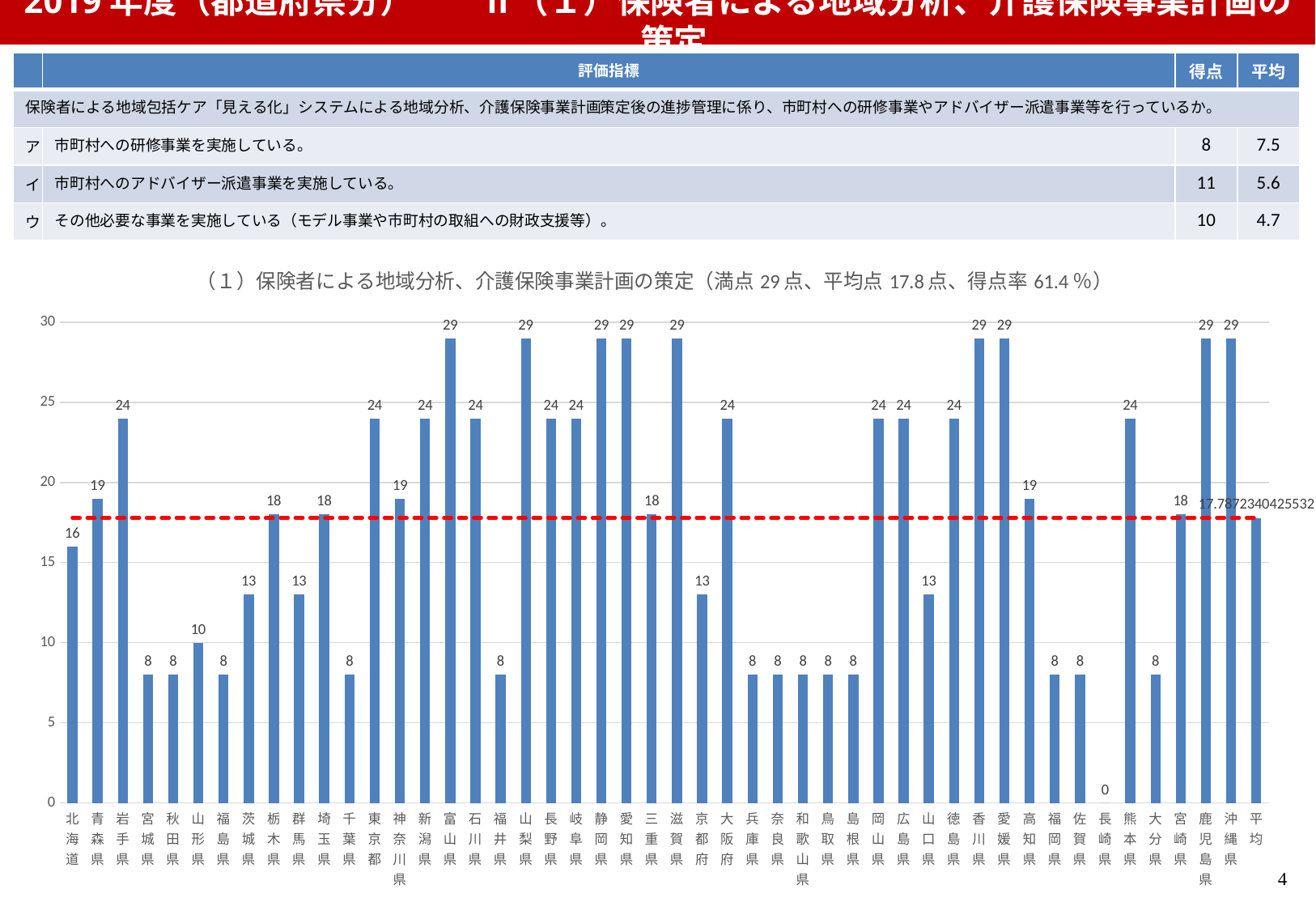
Which has a larger value, 青森県 or 茨城県? 青森県 How many prefectures have a value of 29 in the bar chart? 9 What is the value for 山形県 in the bar chart? 10 What is the 満点 (maximum score) stated in the chart title? 29点 What is the difference between the values for 富山県 and 三重県? 11 What kind of chart is shown on the slide? combination bar and line chart (bars with a dashed average line) Which has a larger value, 高知県 or 熊本県? 熊本県 Which prefecture has the lowest value in the bar chart? 長崎県 What is the value for 京都府 in the bar chart? 13 What is the difference between the values for 岩手県 and 宮城県? 16 What is the value labelled on the 平均 bar at the far right of the chart? 17.7872340425532 What is the value for 北海道 in the bar chart? 16